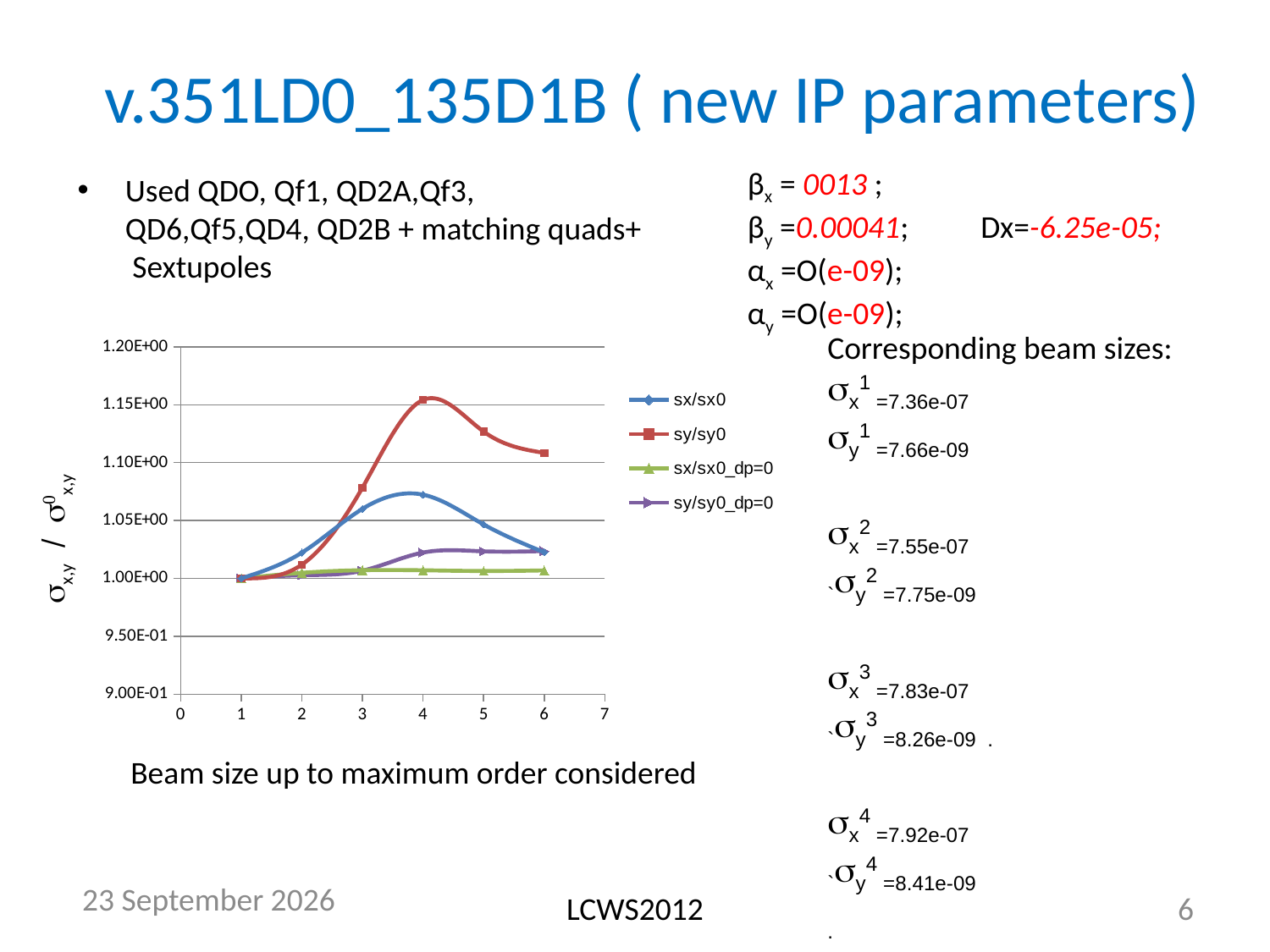
Does the sx/sx0 series rise or fall from x = 1 to x = 4? rise What kind of chart is shown on the slide? line chart How many series does the chart legend list? 4 Which series has the highest value at x = 4? sy/sy0 Is the value of sy/sy0 at x = 5 greater or less than 1.10E+00? greater At x = 5, which is larger: sx/sx0 or sy/sy0? sy/sy0 How many data points does the sy/sy0 series have? 6 Is the value of sx/sx0 at x = 4 greater or less than 1.10E+00? less Does the sy/sy0 series rise or fall from x = 4 to x = 6? fall What is the caption written below the chart? Beam size up to maximum order considered Is the value of sx/sx0_dp=0 at x = 6 greater or less than 1.05E+00? less